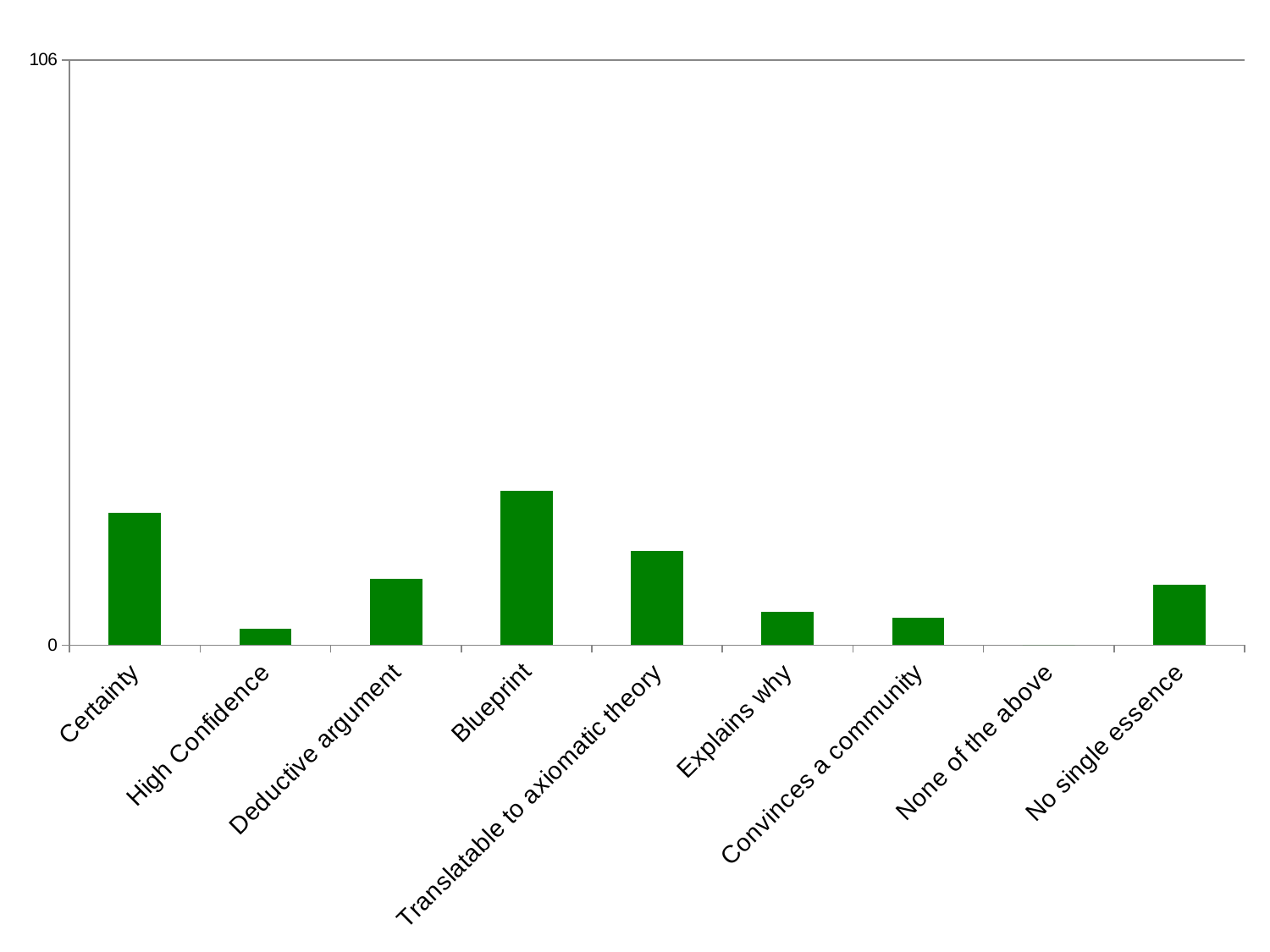
Which category has the lowest bar in the chart? None of the above How many categories are shown on the x axis of the chart? 9 Which is larger, the value for Translatable to axiomatic theory or the value for Explains why? Translatable to axiomatic theory Which is larger, the value for High Confidence or the value for Deductive argument? Deductive argument What is the highest value labelled on the y axis of the chart? 106 Which is larger, the value for Certainty or the value for Blueprint? Blueprint What colour are the bars in the chart? green Which category has the highest bar in the chart? Blueprint What kind of chart is shown on the slide? bar chart